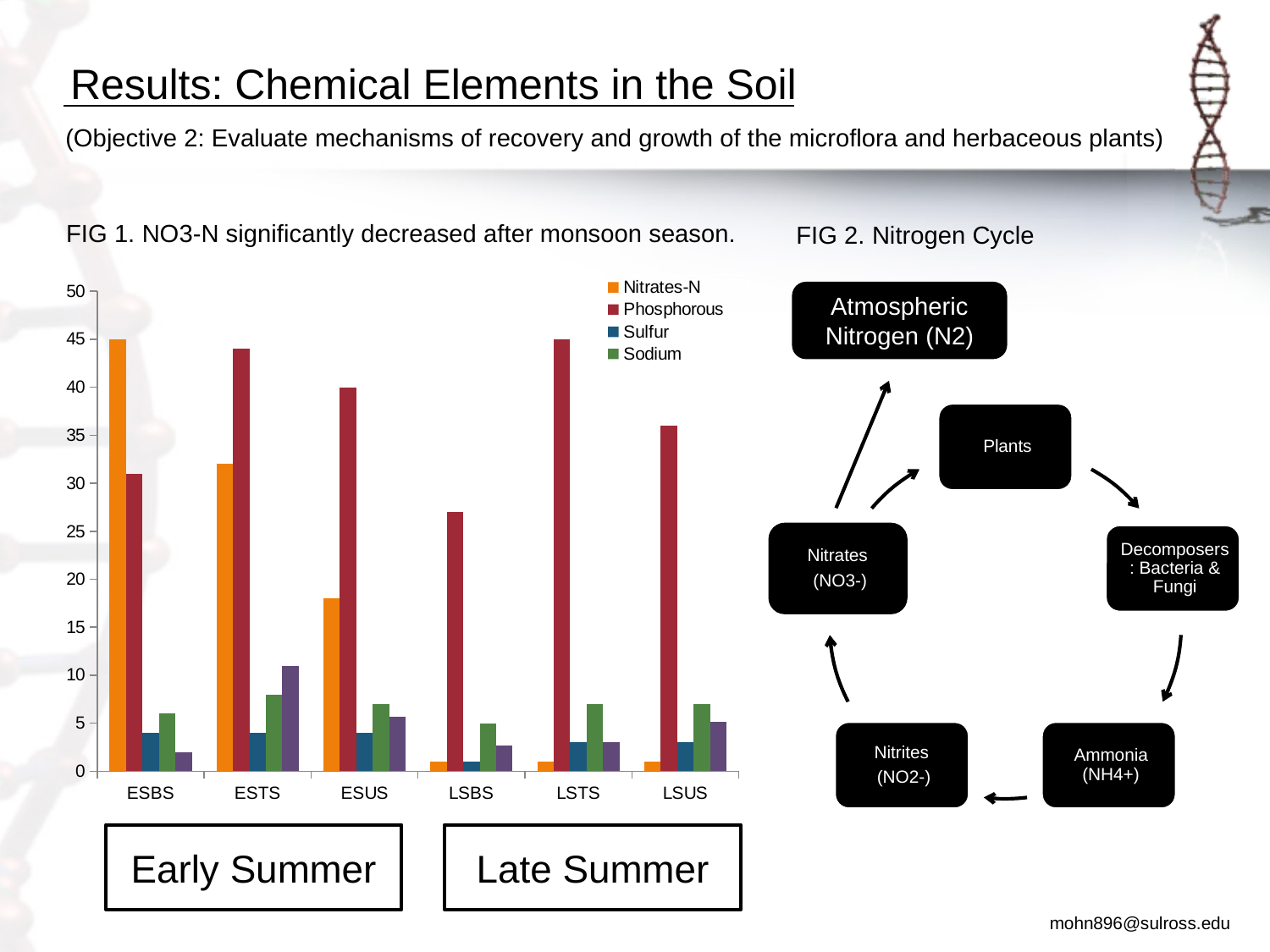
In FIG 1, how many series does the legend list? 4 In FIG 1, which category has the highest Nitrates-N value? ESBS In FIG 1, is the Sodium value for ESTS greater or less than 5? greater In FIG 1, how many categories are shown on the x axis? 6 In FIG 1, is the Nitrates-N value for ESUS greater or less than 20? less In FIG 1, do the Nitrates-N values generally rise or fall from ESBS to LSUS? fall What kind of chart is FIG 1? bar chart In FIG 1, which category has the lowest Phosphorous value? LSBS In FIG 1, is the Phosphorous value for LSBS greater or less than 25? greater What is the caption of FIG 1? NO3-N significantly decreased after monsoon season. In FIG 1, for ESTS, which is larger: Phosphorous or Nitrates-N? Phosphorous